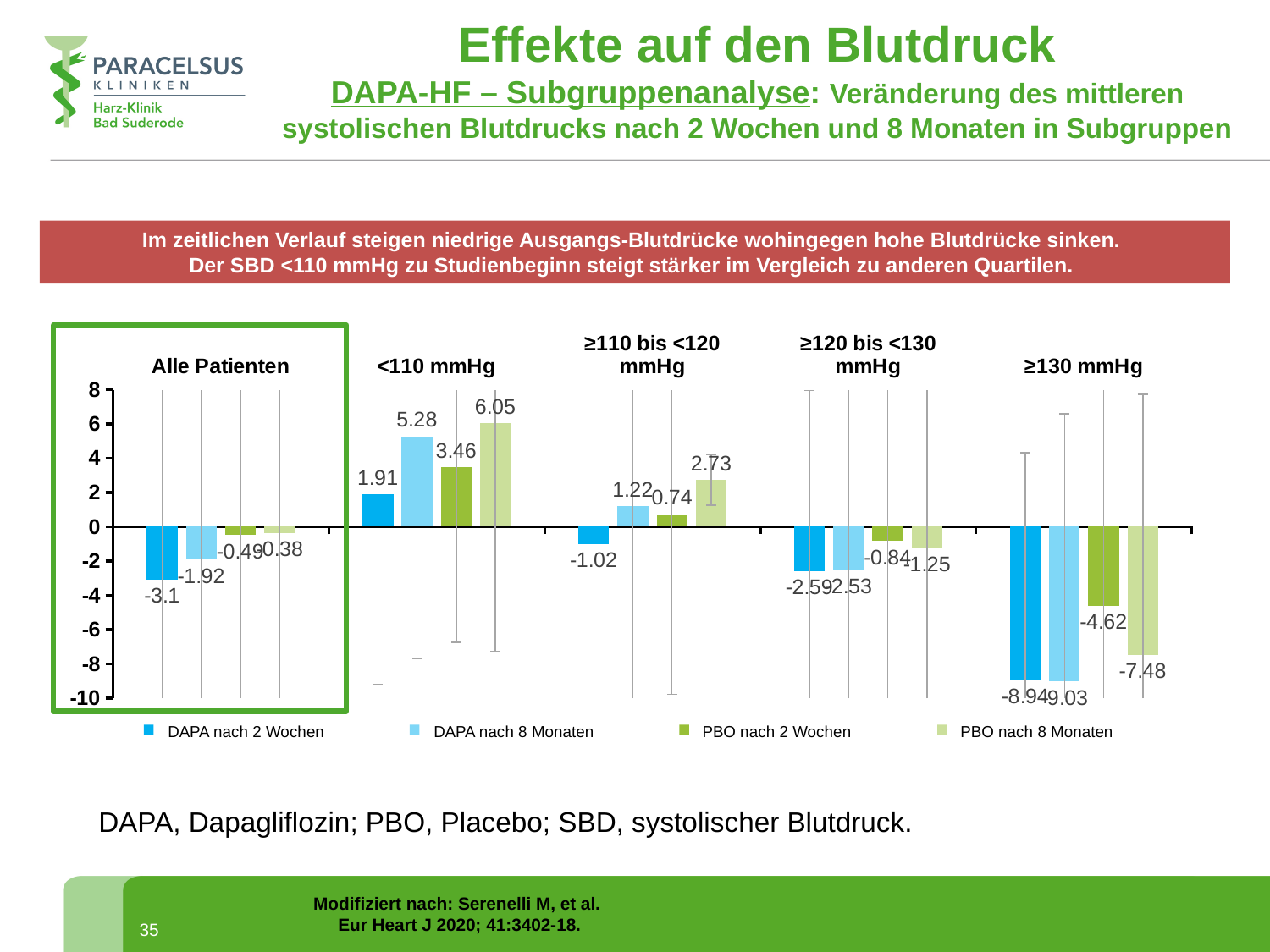
In which subgroup is the PBO nach 8 Monaten value the lowest? ≥130 mmHg What kind of chart is shown on the slide? Bar chart In the <110 mmHg subgroup, which is larger: DAPA nach 8 Monaten or PBO nach 2 Wochen? DAPA nach 8 Monaten Which series has the highest value in the <110 mmHg subgroup? PBO nach 8 Monaten What is the value for DAPA nach 8 Monaten in the <110 mmHg subgroup? 5.28 How many patient groups are shown on the x axis of the chart? 5 What is the value for PBO nach 2 Wochen in the ≥130 mmHg subgroup? -4.62 What is the value for DAPA nach 2 Wochen in the ≥110 bis <120 mmHg subgroup? -1.02 How many series does the legend list? 4 What is the value for DAPA nach 2 Wochen in the Alle Patienten group? -3.1 What is the value for PBO nach 8 Monaten in the ≥110 bis <120 mmHg subgroup? 2.73 What is the difference between PBO nach 8 Monaten and DAPA nach 8 Monaten in the <110 mmHg subgroup? 0.77